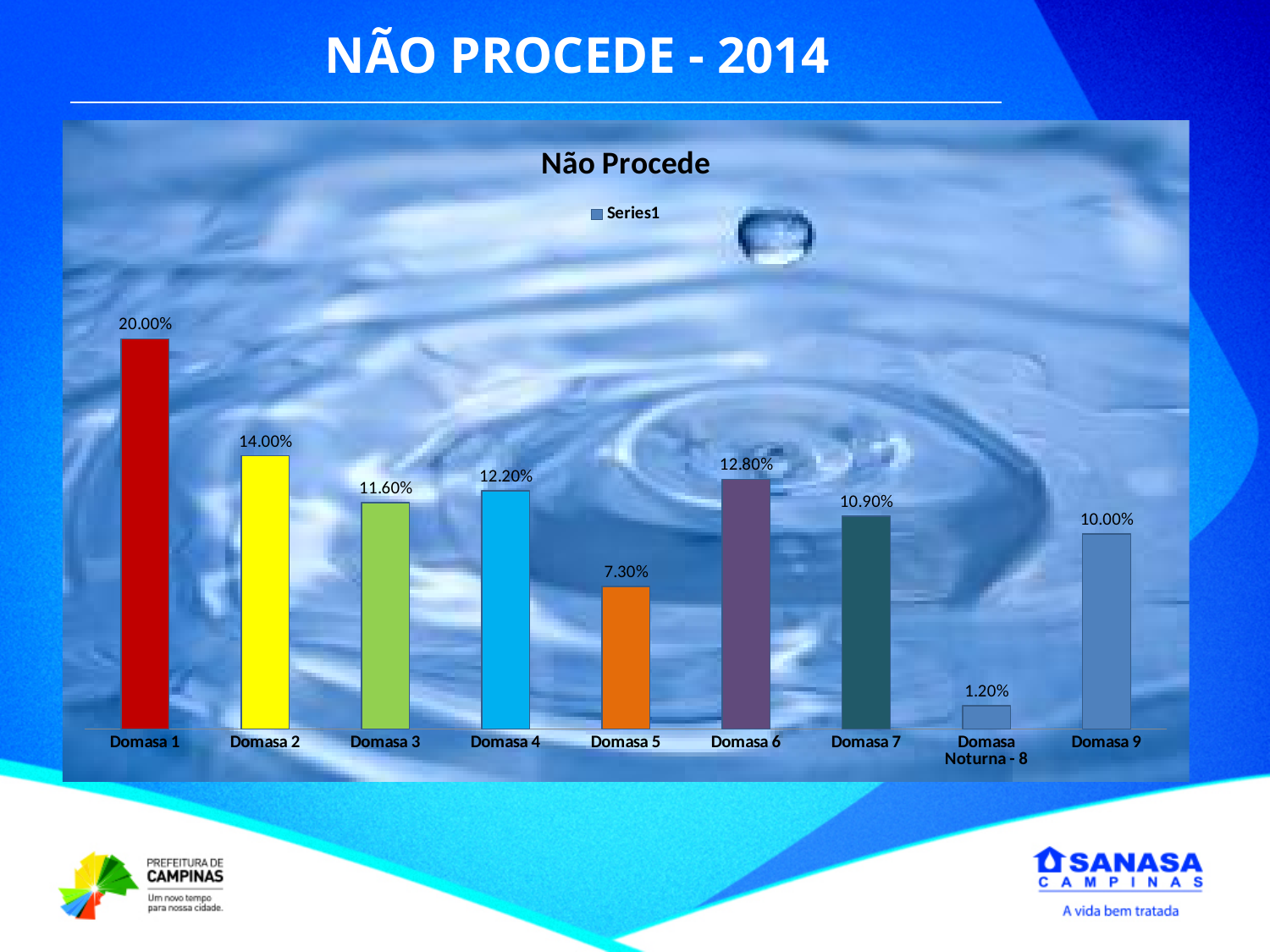
Which category has the highest value? Domasa 1 What is the value for Domasa 5? 7.30% What is the difference between the values for Domasa 1 and Domasa 2? 6.00% What kind of chart is shown? Bar chart How many categories are shown on the x axis? 9 What is the difference between the values for Domasa 6 and Domasa 7? 1.90% What is the value for Domasa Noturna - 8? 1.20% Which category has the lowest value? Domasa Noturna - 8 What is the value for Domasa 9? 10.00% Which is larger, the value for Domasa 3 or the value for Domasa 4? Domasa 4 How many series does the legend list? 1 What is the value for Domasa 1? 20.00%